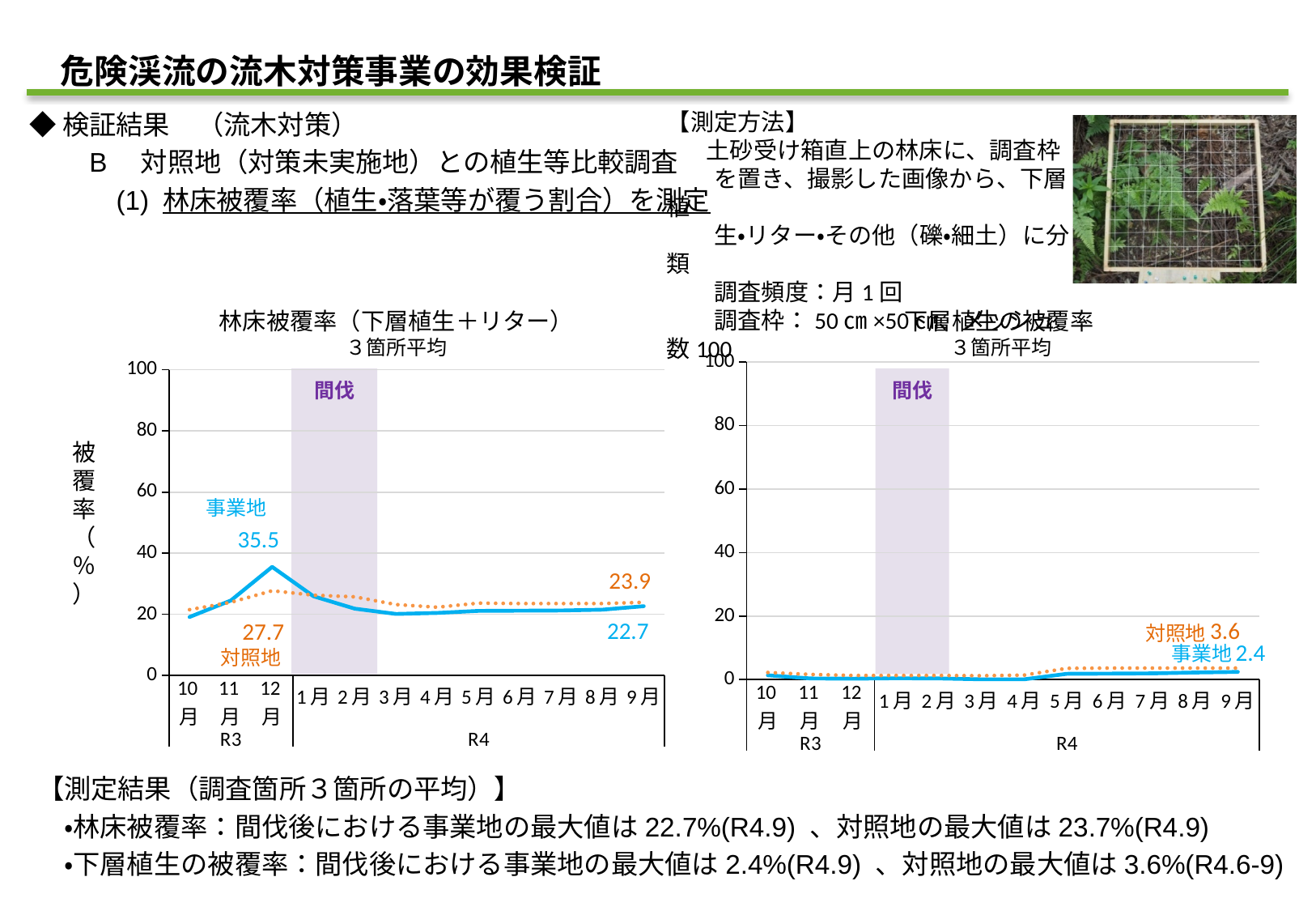
What kind of chart is the left chart titled 林床被覆率（下層植生＋リター）? line chart In the right chart 下層植生の被覆率, what is the difference between the labelled 対照地 value (3.6) and the labelled 事業地 value (2.4)? 1.2 In the left chart 林床被覆率（下層植生＋リター）, what value is labelled for 事業地 at 9月 (R4)? 22.7 How many monthly points are shown along the x axis of the left chart 林床被覆率（下層植生＋リター）? 12 In the right chart 下層植生の被覆率, what value is labelled for 事業地? 2.4 In the left chart 林床被覆率（下層植生＋リター）, in which month does 事業地 reach its highest value? 12月 (R3) In the left chart 林床被覆率（下層植生＋リター）, what value is labelled for 対照地 at 9月 (R4)? 23.9 In the right chart 下層植生の被覆率, what value is labelled for 対照地? 3.6 In the left chart 林床被覆率（下層植生＋リター）, what is the peak value labelled for 事業地? 35.5 In the left chart 林床被覆率（下層植生＋リター）, what is the difference between the 事業地 peak (35.5) and the 対照地 value at 12月 (27.7)? 7.8 In the left chart 林床被覆率（下層植生＋リター）, at 12月 (R3), which series is higher, 事業地 or 対照地? 事業地 In the left chart 林床被覆率（下層植生＋リター）, what value is labelled for 対照地 at 12月 (R3)? 27.7